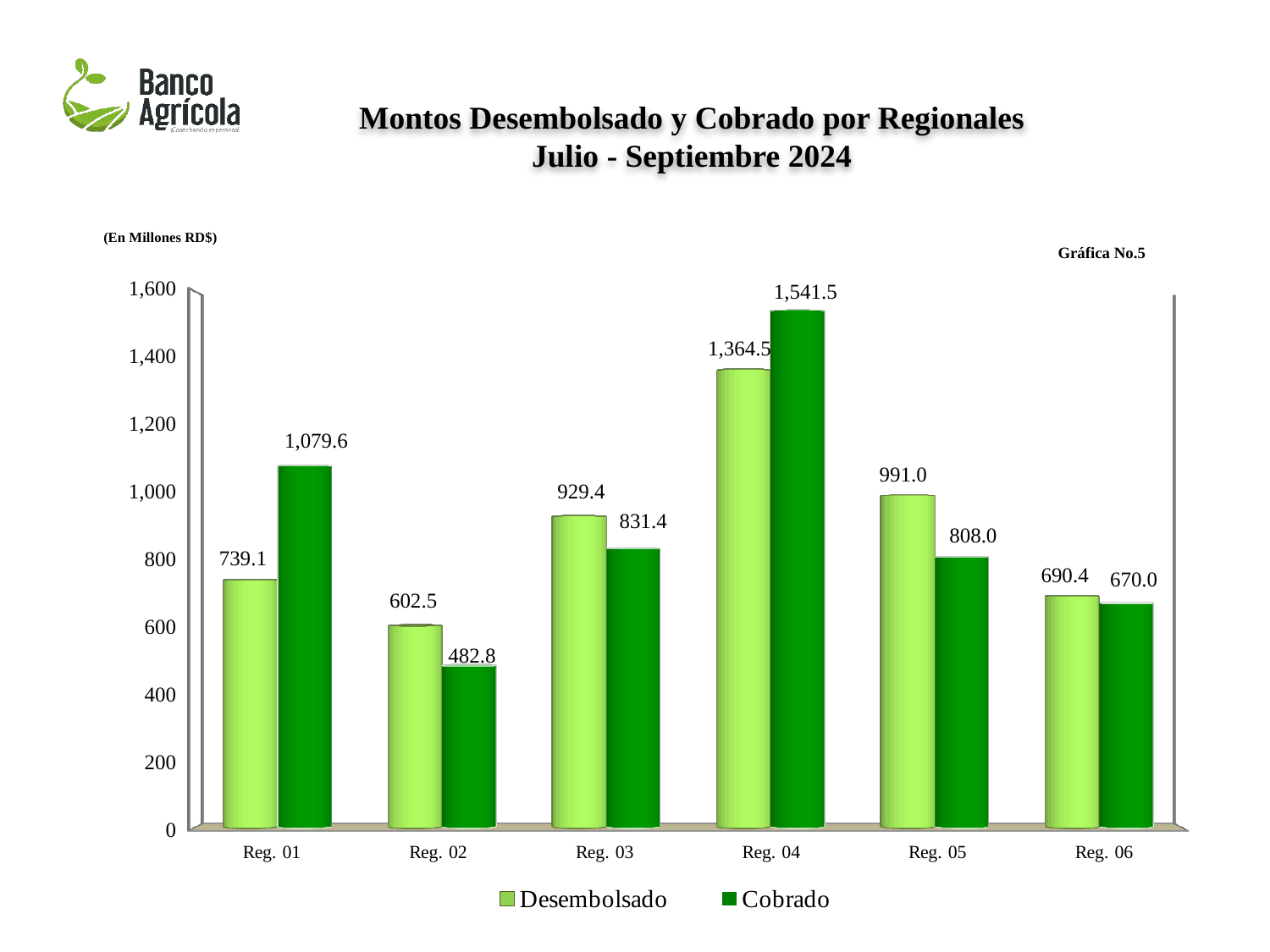
What is the Cobrado value for Reg. 01? 1,079.6 How many regions are shown on the x axis? 6 What kind of chart is shown on the slide? Bar chart Which is larger for Reg. 02, Desembolsado or Cobrado? Desembolsado Which region has the lowest Desembolsado value? Reg. 02 What is the Cobrado value for Reg. 06? 670.0 How many series does the legend list? 2 Which region has the highest Cobrado value? Reg. 04 What unit is stated for the values in the chart? En Millones RD$ What is the difference between the Desembolsado and Cobrado values for Reg. 05? 183.0 What is the difference between the Cobrado and Desembolsado values for Reg. 01? 340.5 What is the Desembolsado value for Reg. 03? 929.4